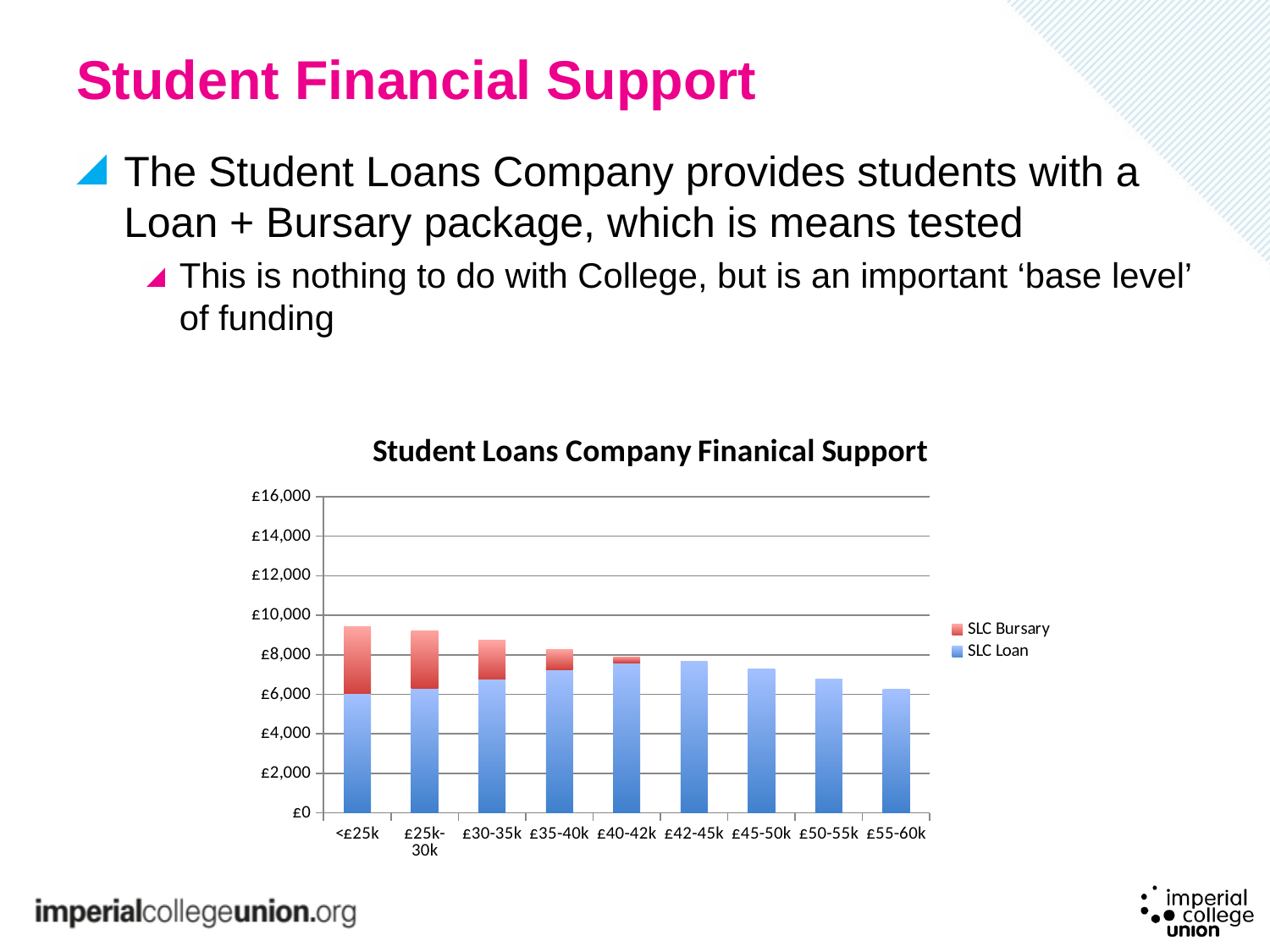
Which is larger: the total bar for £25k-30k or the total bar for £50-55k? £25k-30k Which income category has the lowest total bar in the chart? £55-60k How many series does the chart's legend list? 2 How many income categories show an SLC Bursary segment in the chart? 5 Is the total bar for <£25k greater or less than £8,000? greater How many income categories are shown on the x axis of the chart? 9 Which income category has the highest total bar in the chart? <£25k Do the total bar heights rise or fall as income moves from <£25k to £55-60k? Fall Is the SLC Loan value for £45-50k greater or less than £8,000? less Which two series are listed in the chart's legend? SLC Bursary and SLC Loan What kind of chart is shown on the slide? Stacked bar chart What is the title of the chart? Student Loans Company Finanical Support